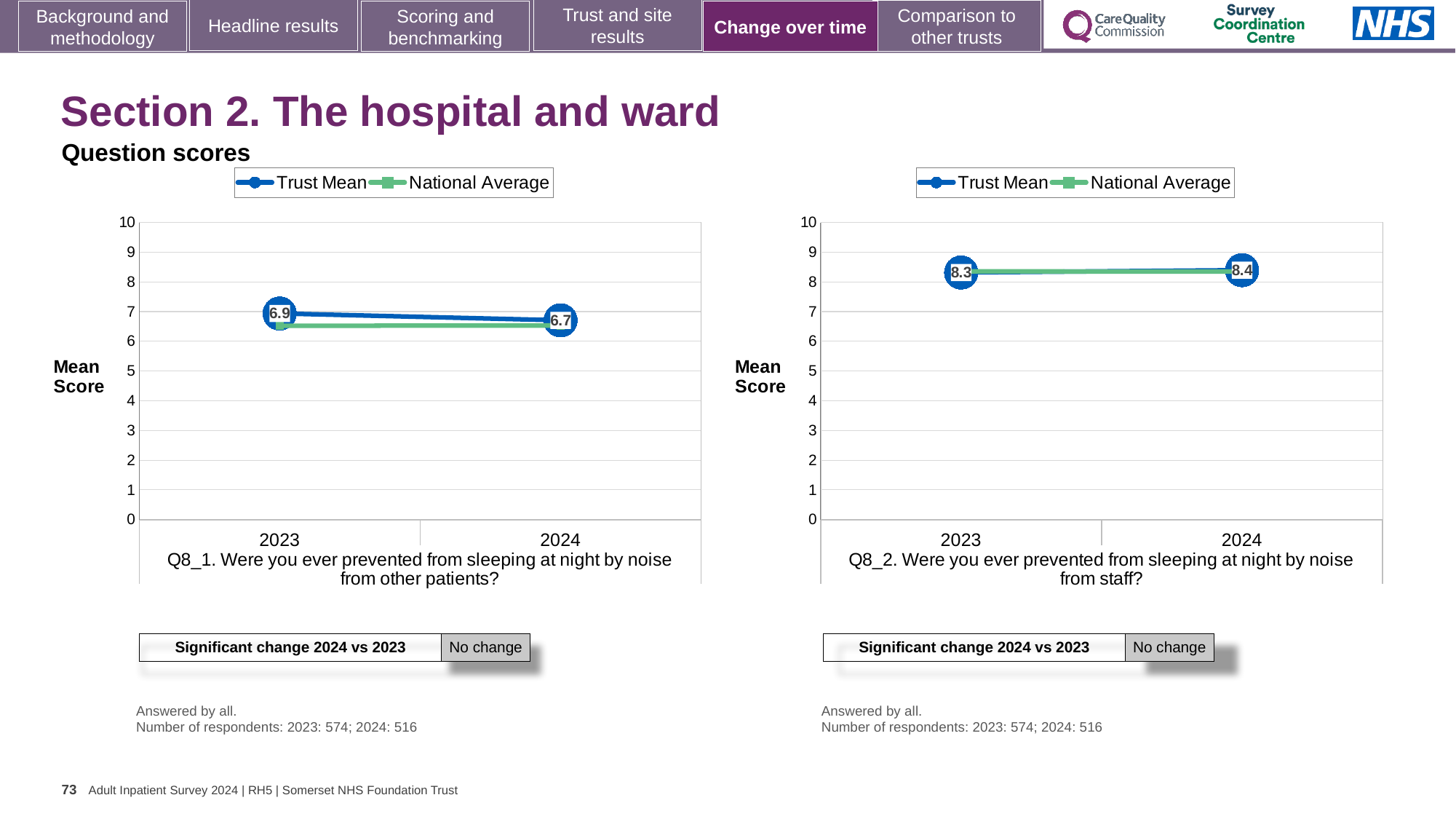
In the left chart (Q8_1), what is the Trust Mean score for 2023? 6.9 In the left chart (Q8_1), by how much did the Trust Mean change from 2023 to 2024? 0.2 What type of chart is used for Q8_2 on the right? line chart In the right chart (Q8_2), what is the Trust Mean score for 2024? 8.4 In the right chart (Q8_2), does the Trust Mean rise or fall from 2023 to 2024? rise In the right chart (Q8_2), what is the Trust Mean score for 2023? 8.3 In the left chart (Q8_1), what is the Trust Mean score for 2024? 6.7 In the right chart (Q8_2), is the National Average value for 2023 greater or less than 8? greater How many series does the legend of the left chart (Q8_1) list? 2 In the right chart (Q8_2), what is the difference between the Trust Mean in 2024 and 2023? 0.1 In the left chart (Q8_1), is the National Average value for 2024 greater or less than 7? less In the left chart (Q8_1), does the Trust Mean rise or fall from 2023 to 2024? fall